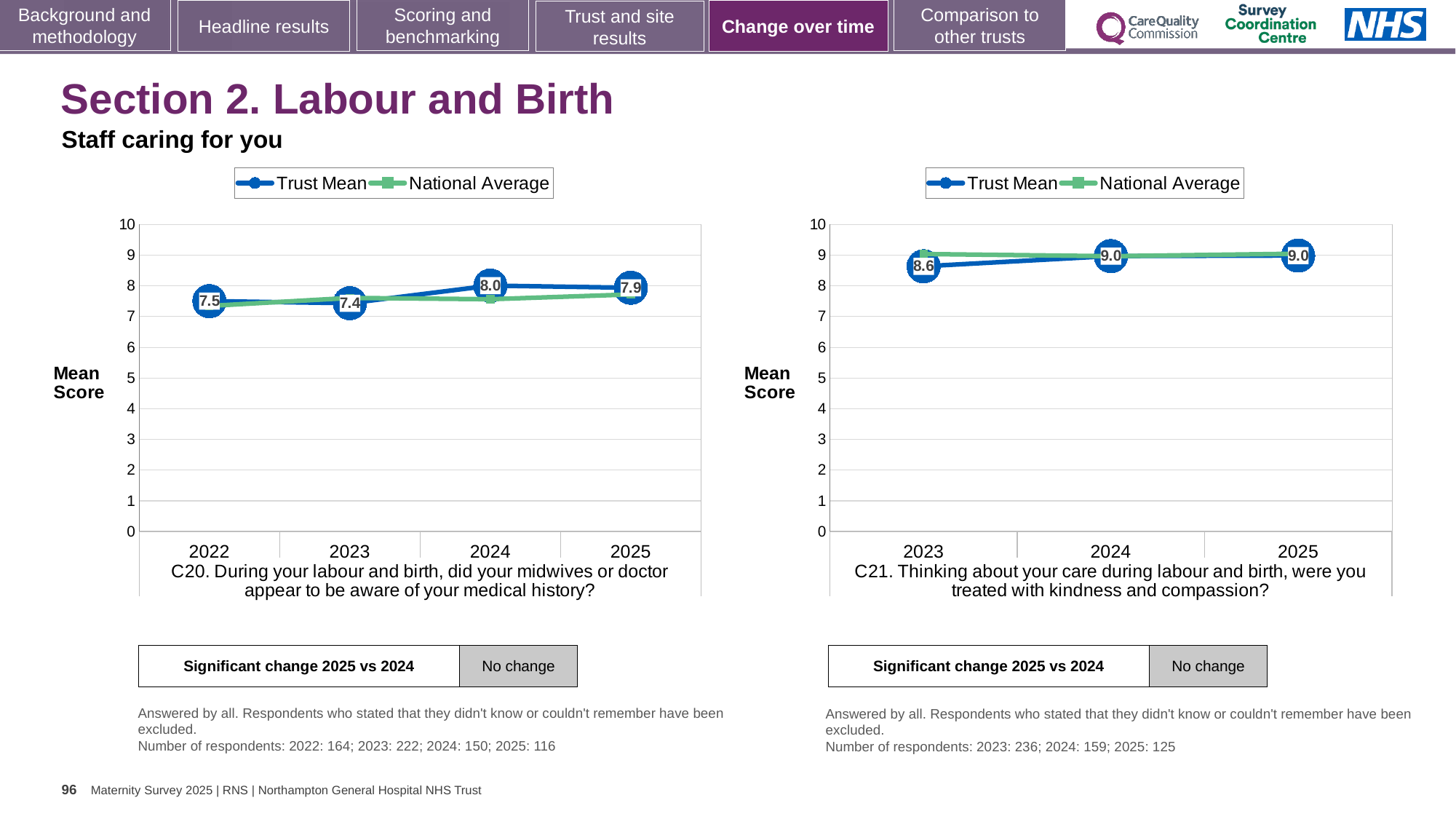
In the C20 chart (left), which year has the lowest Trust Mean score? 2023 In the C20 chart (left), which year has the highest Trust Mean score? 2024 In the C21 chart (right), does the Trust Mean score rise or fall from 2023 to 2024? Rise In the C20 chart (left), is the Trust Mean score higher in 2025 or in 2023? 2025 What type of chart is the C20 chart (left)? Line chart In the C21 chart (right), what is the Trust Mean score for 2023? 8.6 In the C21 chart (right), is the National Average value for 2023 greater or less than 8? greater How many years are plotted on the x axis of the C21 chart (right)? 3 In the C20 chart (left), what is the Trust Mean score for 2022? 7.5 In the C20 chart (left), what is the Trust Mean score for 2024? 8.0 How many series does the legend of the C20 chart (left) list? 2 In the C21 chart (right), what is the difference between the Trust Mean score in 2024 and in 2023? 0.4